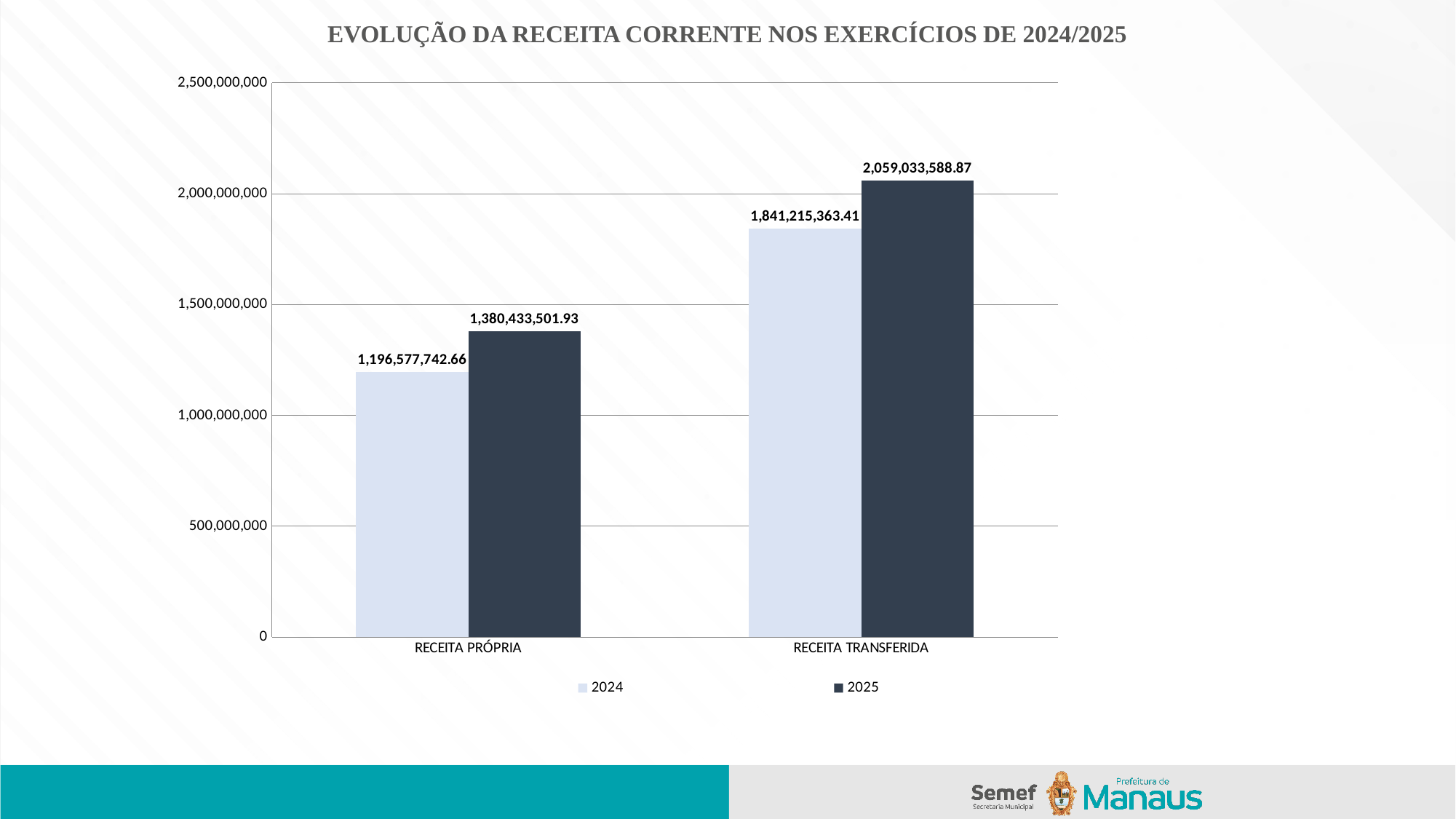
Which bar has the lowest value on the chart? RECEITA PRÓPRIA, 2024 What is the 2024 value for RECEITA TRANSFERIDA? 1,841,215,363.41 What is the 2025 value for RECEITA TRANSFERIDA? 2,059,033,588.87 What is the difference between the 2025 and 2024 values for RECEITA TRANSFERIDA? 217,818,225.46 What is the 2025 value for RECEITA PRÓPRIA? 1,380,433,501.93 What type of chart is shown on the slide? Bar chart How many series does the legend list? 2 Which is larger for RECEITA TRANSFERIDA, the 2024 value or the 2025 value? 2025 Is the 2025 value for RECEITA TRANSFERIDA greater or less than 2,000,000,000? greater Which bar has the highest value on the chart? RECEITA TRANSFERIDA, 2025 What is the 2024 value for RECEITA PRÓPRIA? 1,196,577,742.66 By how much did RECEITA PRÓPRIA increase from 2024 to 2025? 183,855,759.27